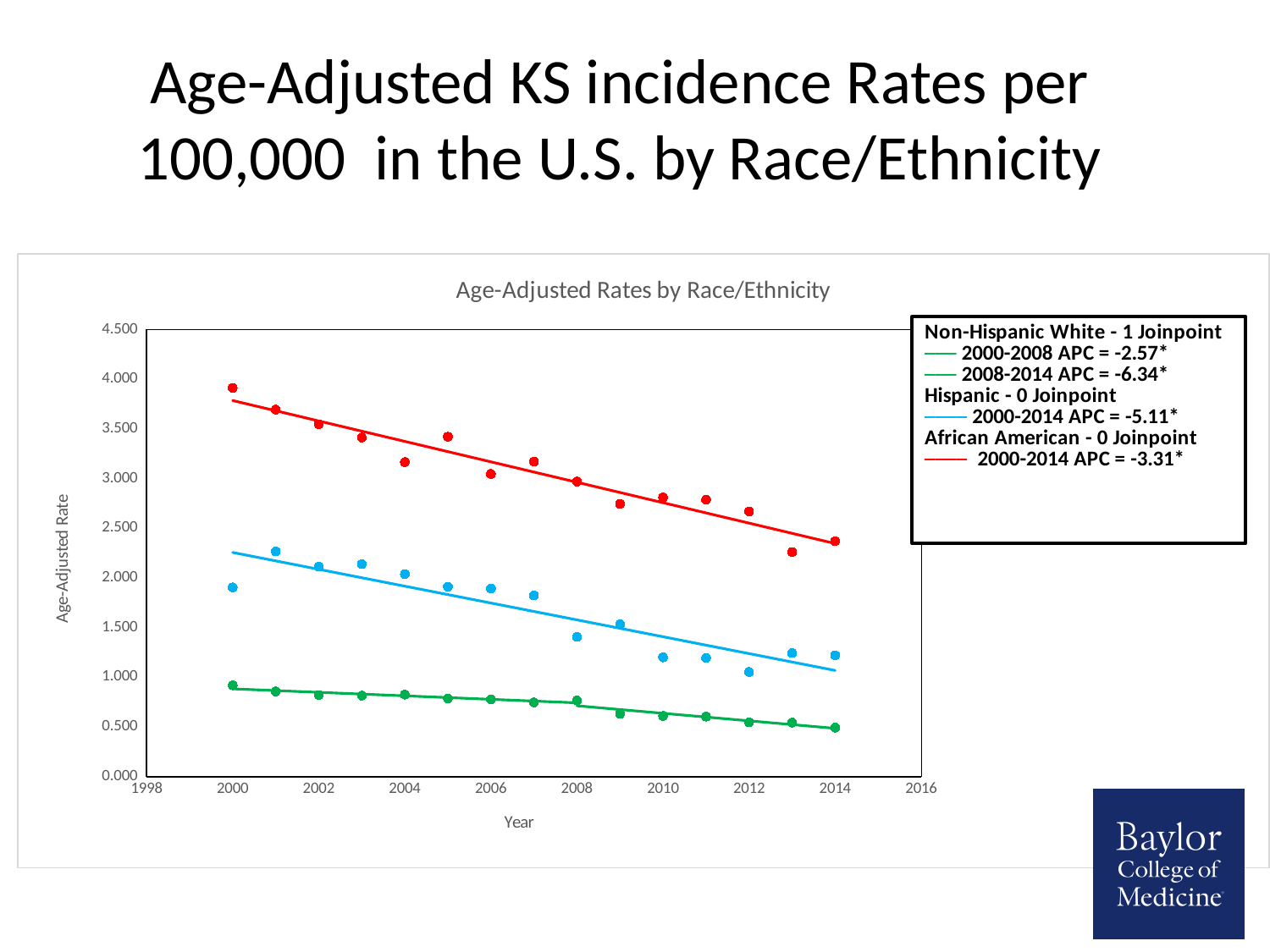
Is the Non-Hispanic White rate in 2000 greater or less than 1.500? less Is the African American rate in 2000 greater or less than 3.500? greater How many race/ethnicity groups are listed in the legend? 3 Do the age-adjusted rates for the Hispanic group rise or fall from 2000 to 2014? Fall In 2014, which group has the higher rate: African American or Hispanic? African American Do the age-adjusted rates for the African American group rise or fall from 2000 to 2014? Fall According to the legend, what is the 2000-2014 APC for the Hispanic group? -5.11* Which race/ethnicity group has the lowest age-adjusted rates across the years shown? Non-Hispanic White What is the title of the chart? Age-Adjusted Rates by Race/Ethnicity What type of chart is shown on the slide? Scatter chart with trend lines Is the Hispanic rate in 2014 greater or less than 1.500? less Which race/ethnicity group has the highest age-adjusted rates across the years shown? African American